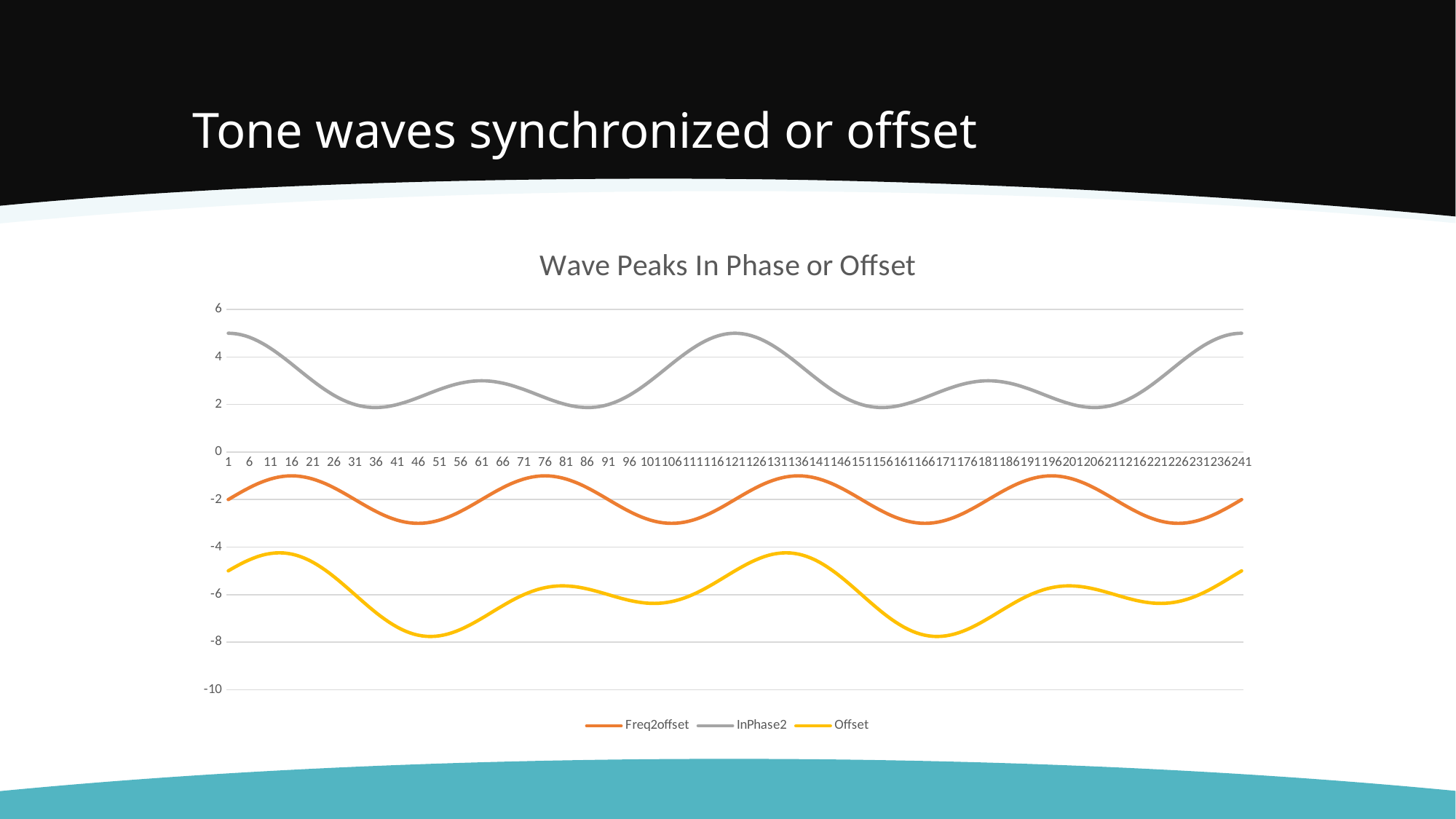
How many series does the legend list? 3 What is the title of the chart? Wave Peaks In Phase or Offset Which series reaches the lowest value on the chart? Offset Which series is drawn in gray according to the legend? InPhase2 What kind of chart is shown on the slide? line chart Is the value of Freq2offset at x = 16 greater or less than -2? greater Is the value of Offset at x = 46 greater or less than -6? less Does the Offset line rise or fall between x = 1 and x = 16? rise Does the InPhase2 line rise or fall between x = 1 and x = 36? fall Which series reaches the highest value on the chart? InPhase2 At x = 121, which series has the larger value, InPhase2 or Freq2offset? InPhase2 Is the value of InPhase2 at x = 1 greater or less than 4? greater